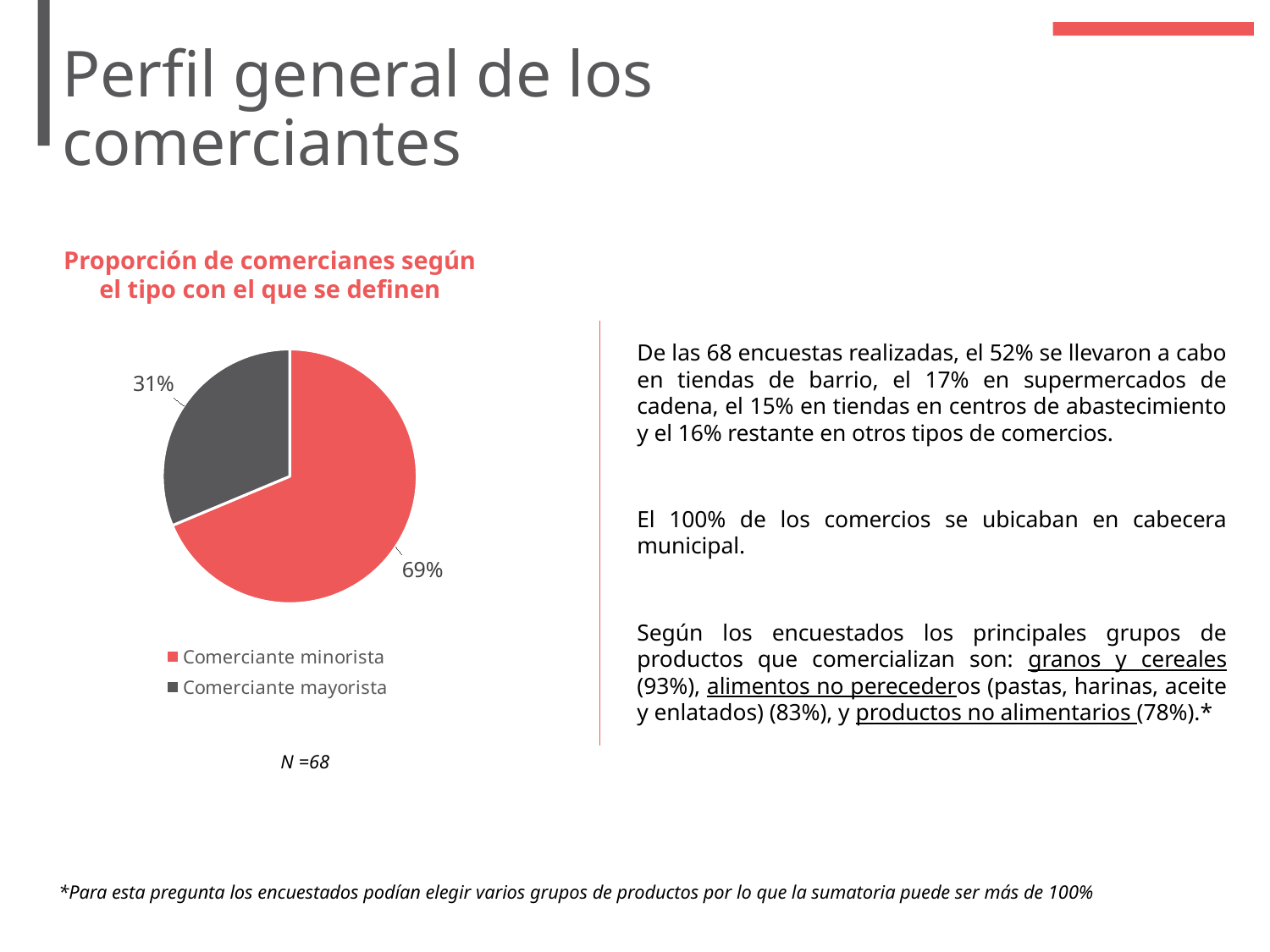
Which is larger, the Comerciante minorista slice or the Comerciante mayorista slice? Comerciante minorista What is the difference in percentage points between the Comerciante minorista and Comerciante mayorista slices? 38 percentage points What is the sample size (N) shown below the chart? N =68 What is the title of the pie chart? Proporción de comercianes según el tipo con el que se definen Which category has the largest slice of the pie? Comerciante minorista How many slices does the pie chart have? 2 What share of the pie is labelled Comerciante minorista? 69% Which category has the smallest slice of the pie? Comerciante mayorista How many entries does the legend list? 2 What kind of chart is shown on the slide? Pie chart What share of the pie is labelled Comerciante mayorista? 31% What colour is the Comerciante mayorista slice? Dark grey